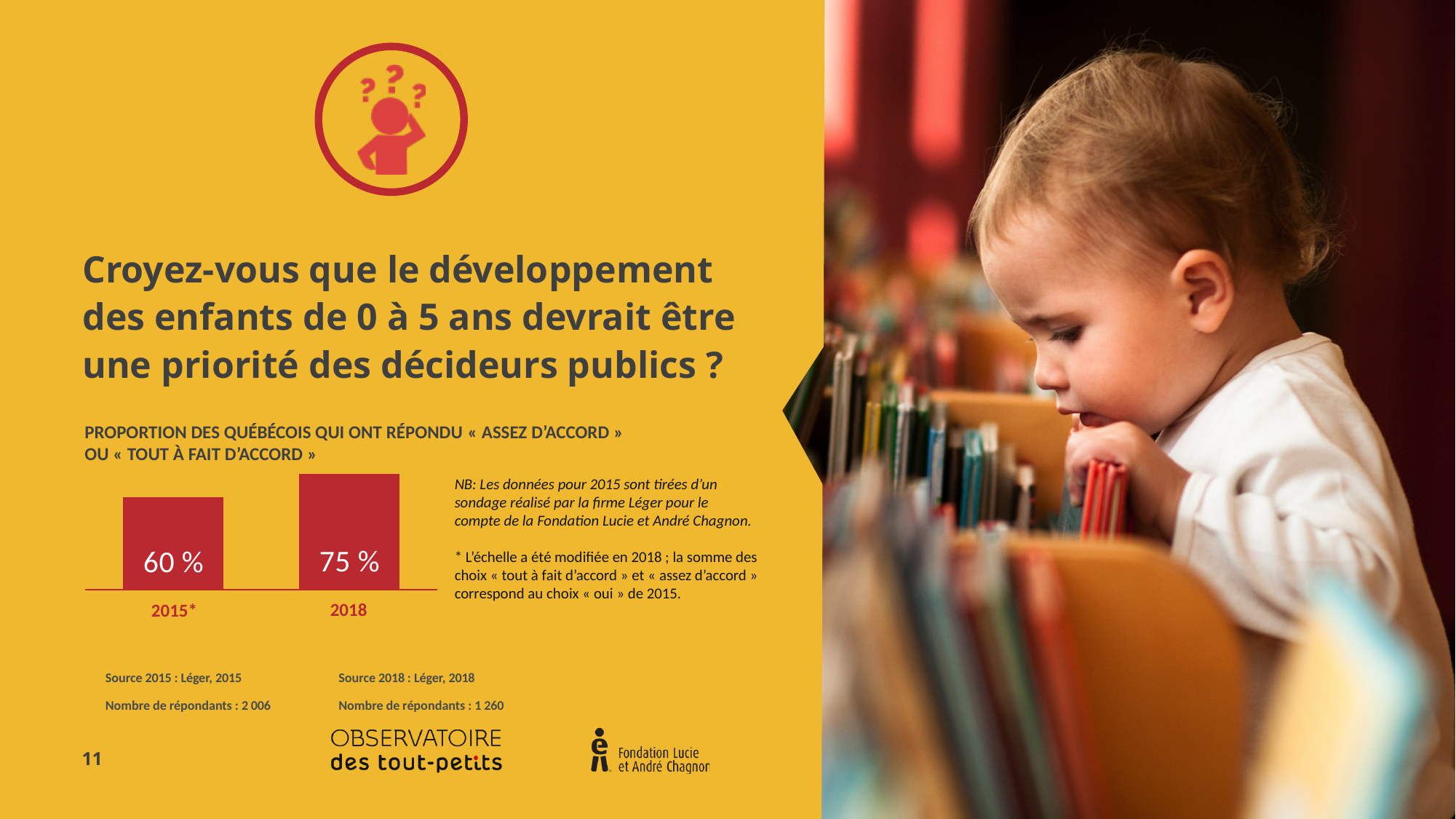
What is the value shown for 2015*? 60 % How many bars are shown in the chart? 2 What is the value shown for 2018? 75 % What kind of chart is shown on the slide? Bar chart Which year has the lower value? 2015* What colour are the bars in the chart? Red Do the values rise or fall from 2015* to 2018? Rise What is the difference between the 2018 value and the 2015* value? 15 % Is the value for 2018 larger than the value for 2015*? Yes What is the number of respondents for the 2018 survey? 1 260 Which year has the higher value? 2018